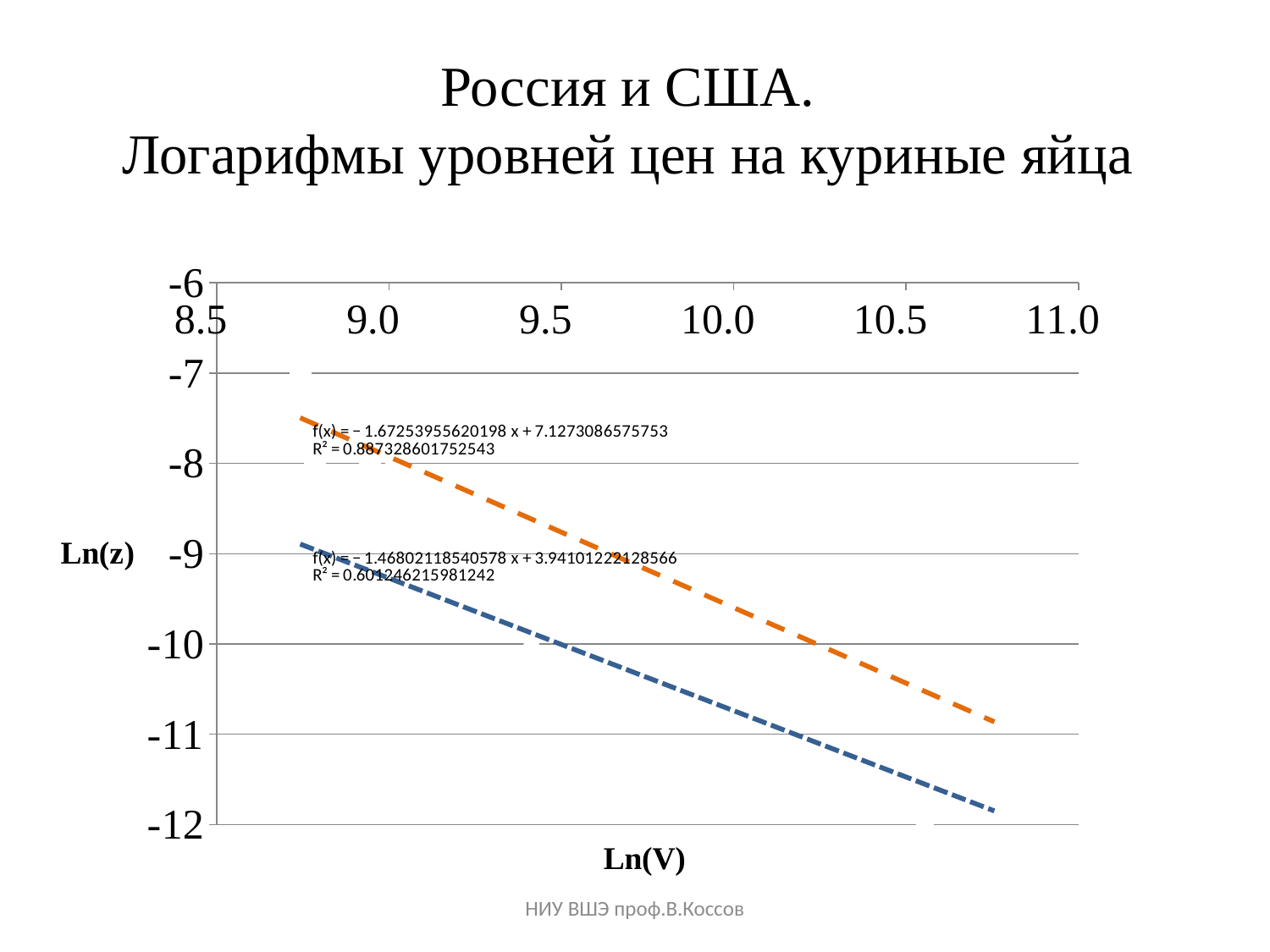
How many dashed lines are plotted on the chart? 2 What is the slope coefficient in the equation printed for the upper (orange) line? -1.67253955620198 What is the label of the horizontal axis? Ln(V) What is the R² value printed for the upper (orange) line? 0.887328601752543 What is the R² value printed for the lower (blue) line? 0.601246215981242 Do the plotted lines rise or fall as Ln(V) increases? fall At Ln(V) = 10.0, is the value of the orange line greater or less than -10? greater What kind of chart is shown on the slide? line chart Which line has the higher R² value, the orange line or the blue line? orange line What is the label of the vertical axis? Ln(z) At Ln(V) = 10.5, is the value of the blue line greater or less than -11? less What is the intercept in the equation printed for the lower (blue) line? 3.94101222128566